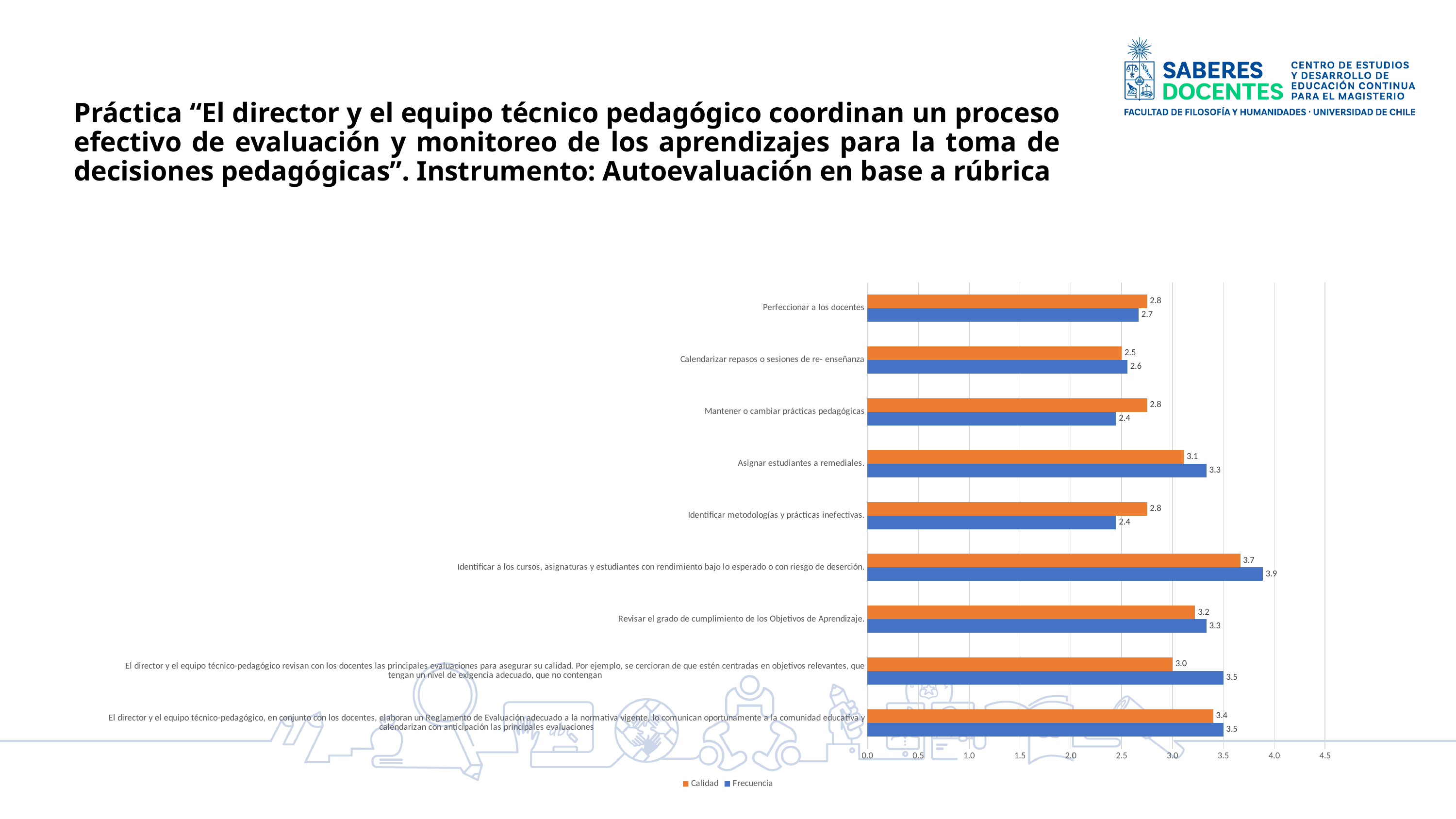
How many categories are shown in the chart? 9 What type of chart is shown on the slide? Bar chart What is the difference between the Frecuencia and Calidad values for "El director y el equipo técnico-pedagógico revisan con los docentes las principales evaluaciones..."? 0.5 Which category has the lowest Calidad value? Calendarizar repasos o sesiones de re- enseñanza For "Identificar metodologías y prácticas inefectivas.", which is larger: Calidad or Frecuencia? Calidad What is the Frecuencia value for "Mantener o cambiar prácticas pedagógicas"? 2.4 What is the Frecuencia value for "Asignar estudiantes a remediales."? 3.3 How many series does the legend list? 2 What is the Calidad value for "Perfeccionar a los docentes"? 2.8 Is the Frecuencia value for "Identificar a los cursos, asignaturas y estudiantes con rendimiento bajo lo esperado o con riesgo de deserción." greater or less than 3.5? greater Which colour represents the Frecuencia series? Blue Which category has the highest Frecuencia value? Identificar a los cursos, asignaturas y estudiantes con rendimiento bajo lo esperado o con riesgo de deserción.